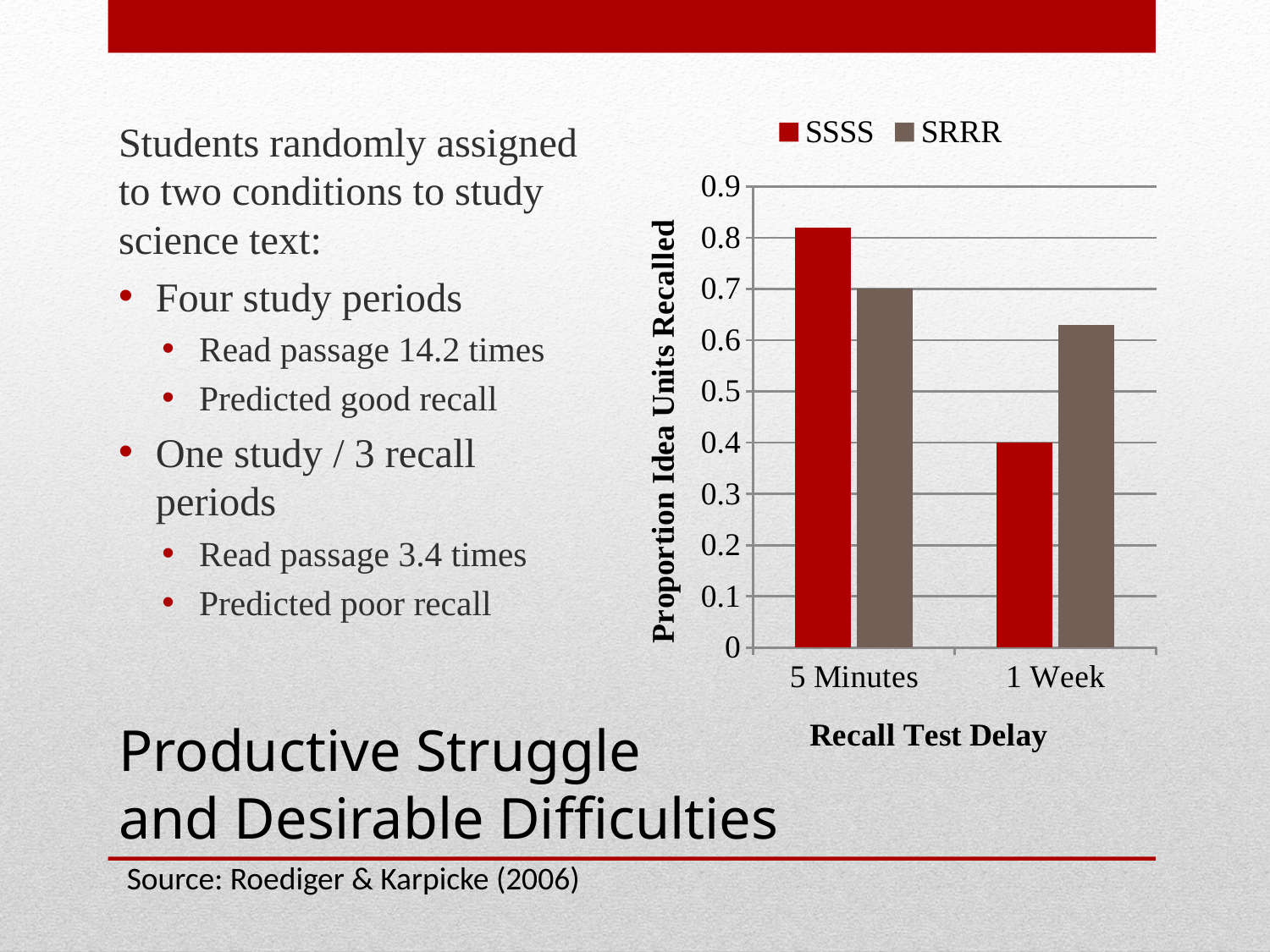
Which bar in the chart is the lowest? SSSS at 1 Week Is the value for SRRR at 1 Week greater or less than 0.6? greater What kind of chart is shown on the slide? bar chart What are the two series named in the chart legend? SSSS and SRRR Which bar in the chart is the highest? SSSS at 5 Minutes How many categories are shown on the x axis of the chart? 2 Is the value for SSSS at 5 Minutes greater or less than 0.8? greater Which series has the higher value at 5 Minutes, SSSS or SRRR? SSSS How many series does the chart legend list? 2 What is the x-axis title of the chart? Recall Test Delay Which series has the higher value at 1 Week, SSSS or SRRR? SRRR Is the value for SSSS at 1 Week greater or less than 0.5? less